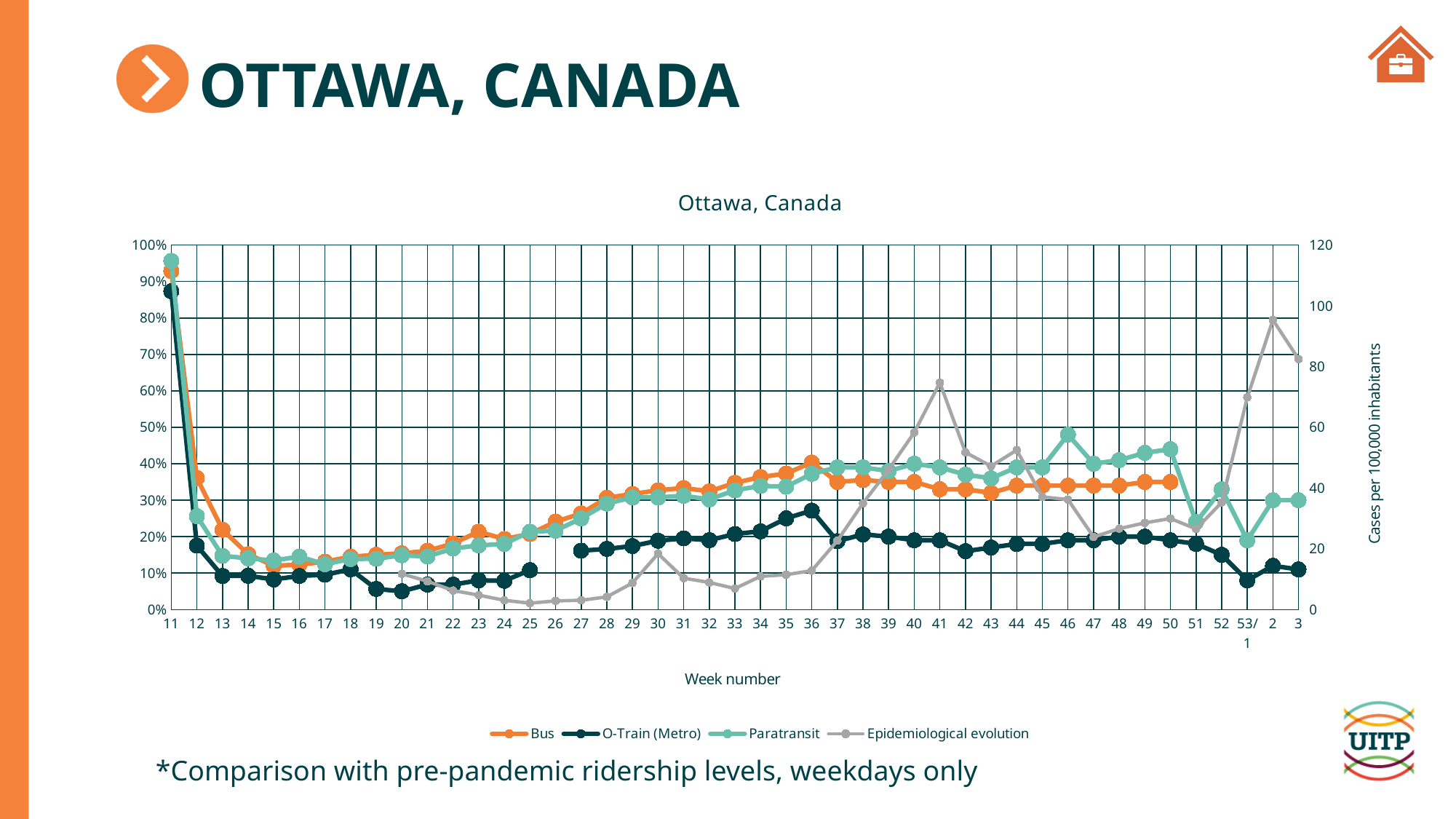
At week 36, which is larger: the Bus value or the O-Train (Metro) value? Bus How many series does the legend list? 4 What is the label of the right-hand vertical axis? Cases per 100,000 inhabitants Is the O-Train (Metro) value at week 13 greater or less than 20%? less What kind of chart is shown on the slide? line chart Is the Bus value at week 36 greater or less than 30%? greater At week 46, which is larger: the Paratransit value or the Bus value? Paratransit At which week does the Epidemiological evolution series reach its highest value? 2 Does the Bus series rise or fall from week 11 to week 15? fall Is the Epidemiological evolution value at week 41 greater or less than 60? greater What is the title of the chart? Ottawa, Canada Among Bus, O-Train (Metro) and Paratransit, which series has the lowest value at week 13? O-Train (Metro)